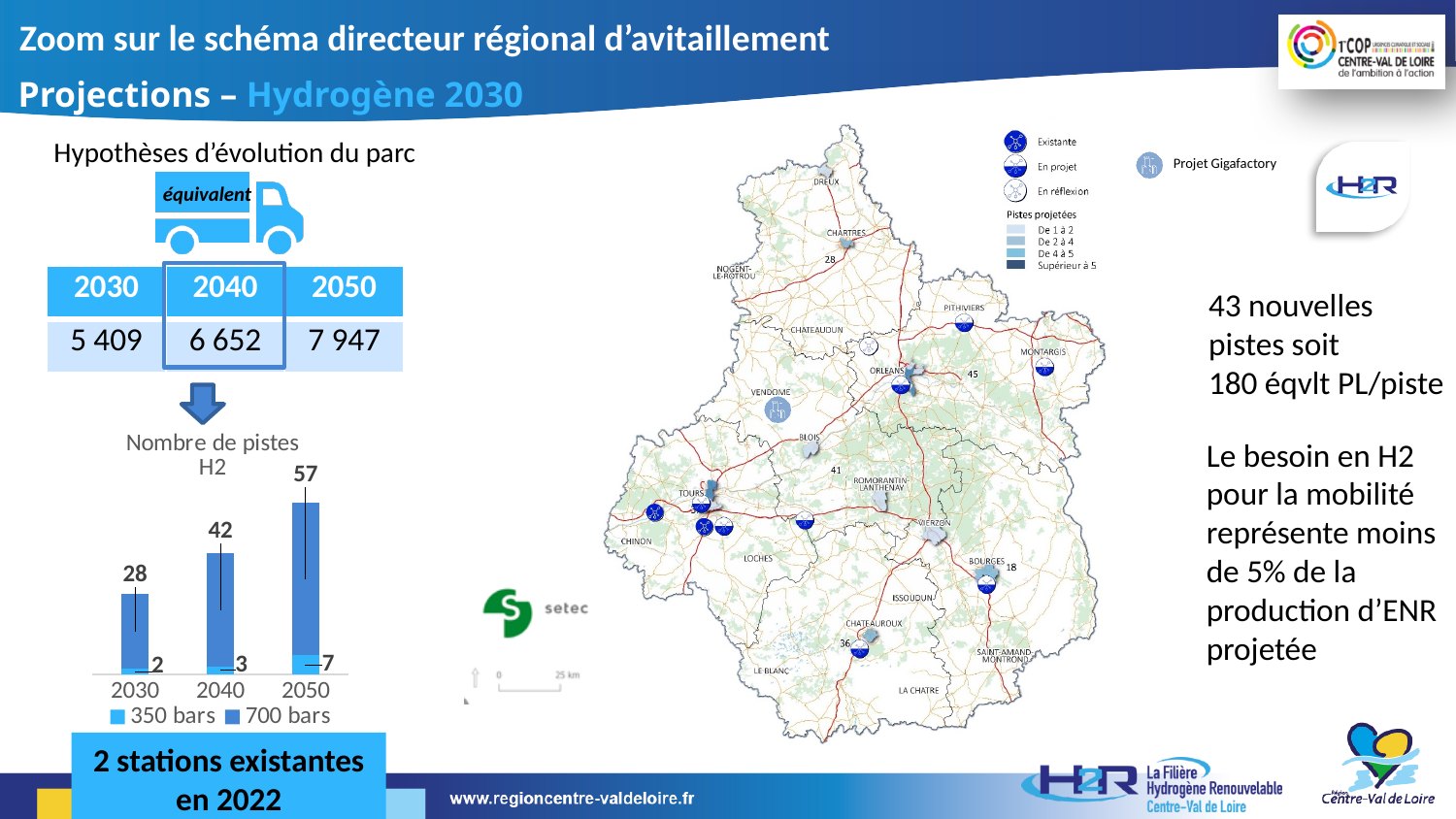
How many series does the legend of the "Nombre de pistes H2" chart list? 2 What type of chart is the "Nombre de pistes H2" chart? bar chart In the "Nombre de pistes H2" chart, what number is printed above the 2050 bar? 57 How many years are shown on the x axis of the "Nombre de pistes H2" chart? 3 What are the two series named in the legend of the "Nombre de pistes H2" chart? 350 bars and 700 bars In the "Nombre de pistes H2" chart, which year has the tallest bar? 2050 In the "Nombre de pistes H2" chart, what is the value of the 350 bars segment for 2050? 7 In the "Nombre de pistes H2" chart, what number is printed above the 2030 bar? 28 In the "Nombre de pistes H2" chart, what is the value of the 350 bars segment for 2030? 2 In the "Nombre de pistes H2" chart, which year has the shortest bar? 2030 In the "Nombre de pistes H2" chart, do the bar heights rise or fall from 2030 to 2050? rise In the "Nombre de pistes H2" chart, what is the value of the 350 bars segment for 2040? 3